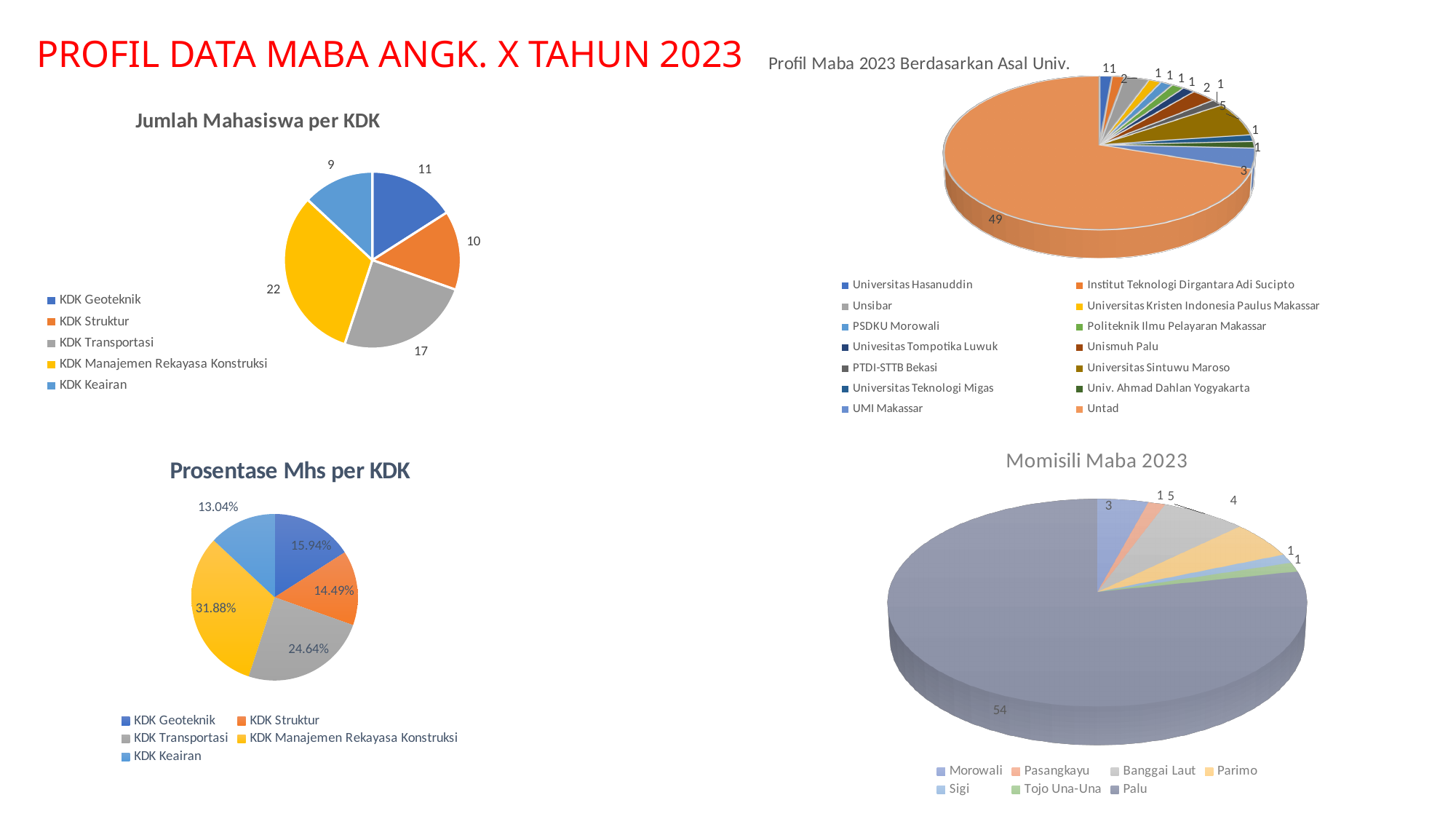
What type of chart is 'Momisili Maba 2023'? Pie chart How many universities does the legend of the 'Profil Maba 2023 Berdasarkan Asal Univ.' chart list? 14 In the 'Jumlah Mahasiswa per KDK' chart, what is the value for KDK Keairan? 9 In the 'Jumlah Mahasiswa per KDK' chart, what is the value for KDK Manajemen Rekayasa Konstruksi? 22 How many categories does the legend of the 'Prosentase Mhs per KDK' chart list? 5 In the 'Jumlah Mahasiswa per KDK' chart, which is larger, KDK Geoteknik or KDK Struktur? KDK Geoteknik In the 'Prosentase Mhs per KDK' chart, which KDK has the highest percentage? KDK Manajemen Rekayasa Konstruksi In the 'Jumlah Mahasiswa per KDK' chart, what is the difference between KDK Transportasi and KDK Struktur? 7 In the 'Prosentase Mhs per KDK' chart, what percentage is shown for KDK Transportasi? 24.64% In the 'Profil Maba 2023 Berdasarkan Asal Univ.' chart, what is the value of the largest slice (Untad)? 49 In the 'Jumlah Mahasiswa per KDK' chart, which KDK has the lowest number of students? KDK Keairan In the 'Momisili Maba 2023' chart, what is the value for Palu? 54